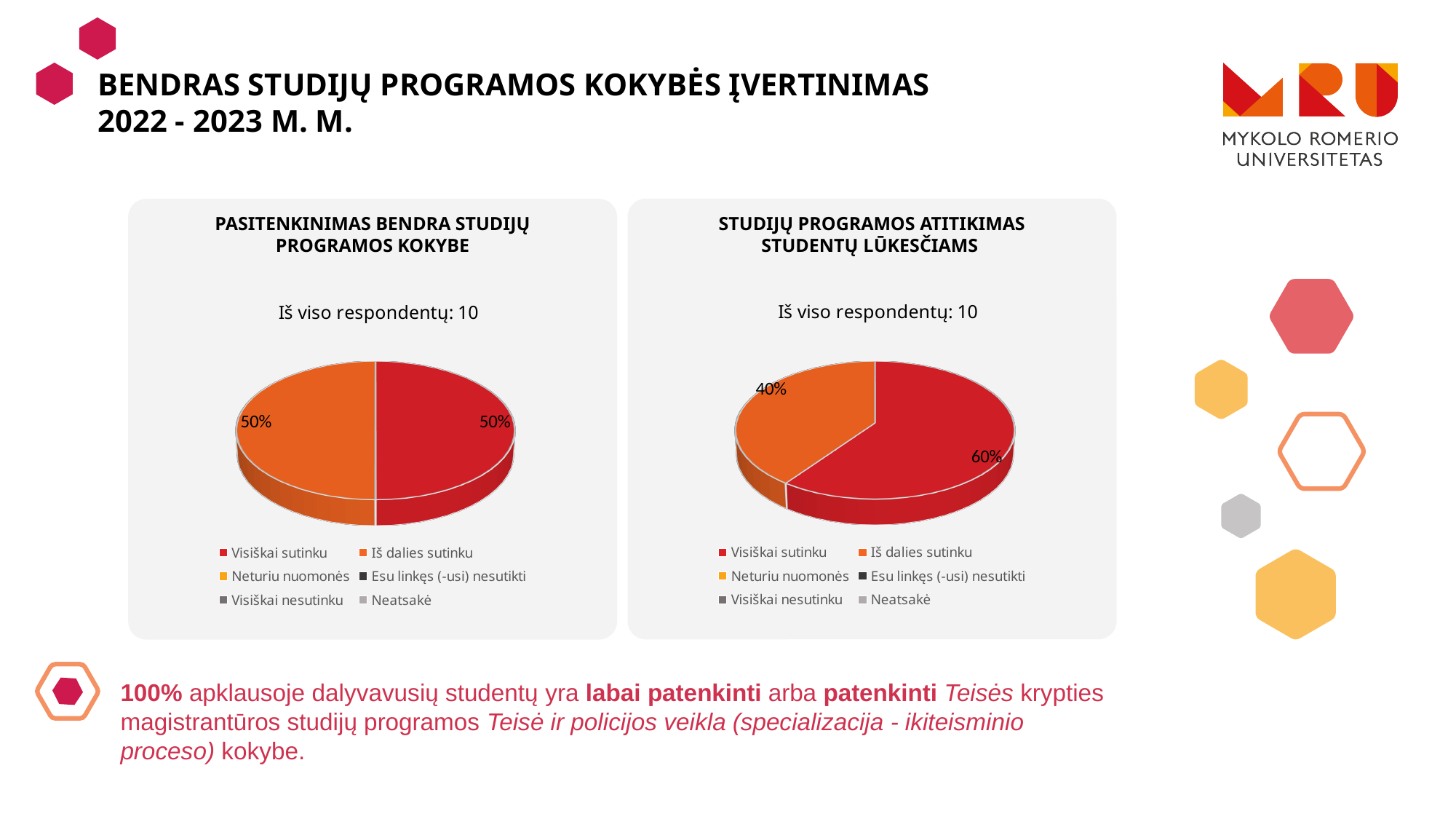
What type of chart is used in the chart titled "PASITENKINIMAS BENDRA STUDIJŲ PROGRAMOS KOKYBE"? Pie chart In the chart titled "PASITENKINIMAS BENDRA STUDIJŲ PROGRAMOS KOKYBE", what share of respondents answered "Visiškai sutinku"? 50% In the chart titled "STUDIJŲ PROGRAMOS ATITIKIMAS STUDENTŲ LŪKESČIAMS", which answer has the smallest slice? Iš dalies sutinku In the chart titled "STUDIJŲ PROGRAMOS ATITIKIMAS STUDENTŲ LŪKESČIAMS", which answer has the largest slice? Visiškai sutinku In the chart titled "STUDIJŲ PROGRAMOS ATITIKIMAS STUDENTŲ LŪKESČIAMS", what share of respondents answered "Visiškai sutinku"? 60% In the chart titled "STUDIJŲ PROGRAMOS ATITIKIMAS STUDENTŲ LŪKESČIAMS", what is the difference in percentage points between the "Visiškai sutinku" and "Iš dalies sutinku" slices? 20 percentage points How many slices are shown in the pie chart titled "PASITENKINIMAS BENDRA STUDIJŲ PROGRAMOS KOKYBE"? 2 How many respondents in total are reported for the chart titled "PASITENKINIMAS BENDRA STUDIJŲ PROGRAMOS KOKYBE"? 10 In the chart titled "PASITENKINIMAS BENDRA STUDIJŲ PROGRAMOS KOKYBE", what share of respondents answered "Iš dalies sutinku"? 50% In the chart titled "STUDIJŲ PROGRAMOS ATITIKIMAS STUDENTŲ LŪKESČIAMS", which is larger: the "Visiškai sutinku" slice or the "Iš dalies sutinku" slice? Visiškai sutinku How many entries does the legend list in the chart titled "STUDIJŲ PROGRAMOS ATITIKIMAS STUDENTŲ LŪKESČIAMS"? 6 In the chart titled "STUDIJŲ PROGRAMOS ATITIKIMAS STUDENTŲ LŪKESČIAMS", what share of respondents answered "Iš dalies sutinku"? 40%